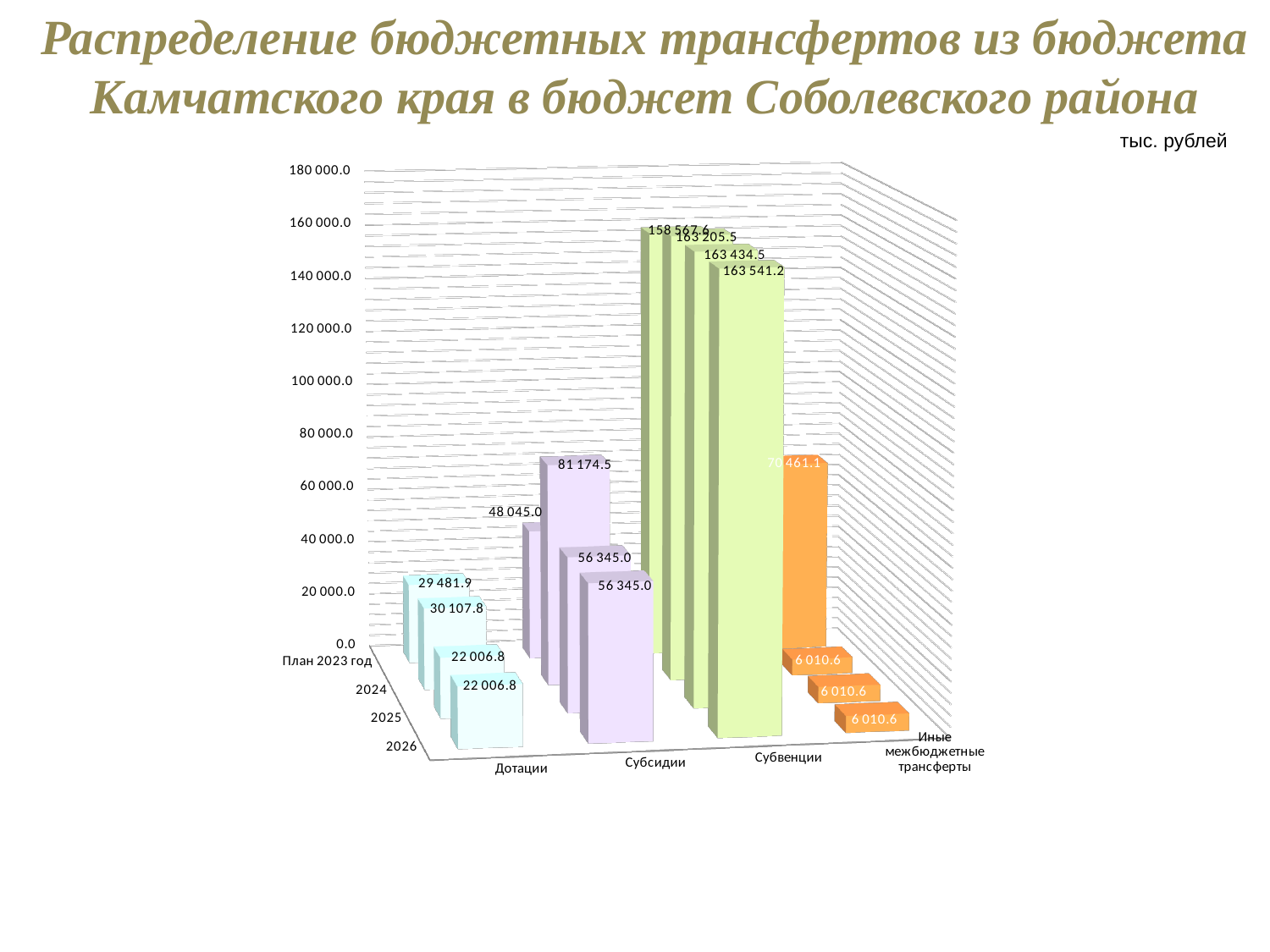
Which category has the highest value in 2024? Субвенции What is the value for Дотации in 2026? 22 006.8 What is the value for Дотации in План 2023 год? 29 481.9 What is the difference between the Субсидии values for 2024 and 2025? 24 829.5 Which is larger: Дотации in 2024 or Дотации in План 2023 год? Дотации in 2024 What type of chart is shown on the slide? bar chart What is the value for Субсидии in 2024? 81 174.5 Which category has the lowest value in 2025? Иные межбюджетные трансферты What unit is indicated for the values on the slide? тыс. рублей What is the value for Иные межбюджетные трансферты in План 2023 год? 70 461.1 How many categories are shown on the horizontal axis? 4 What is the value for Субвенции in 2026? 163 541.2